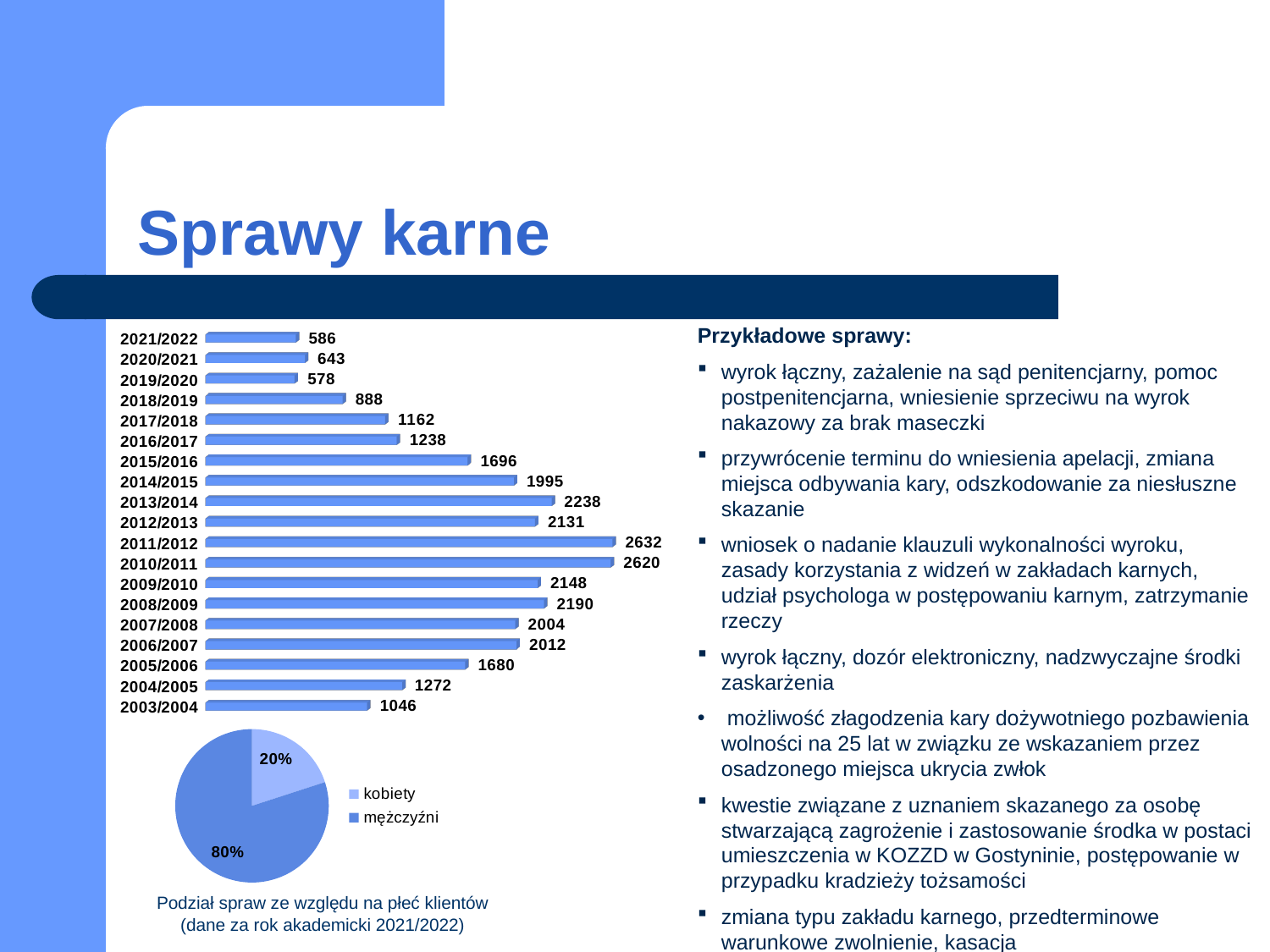
In the pie chart at the bottom left, what share is labelled for kobiety? 20% How many entries does the legend of the pie chart at the bottom left list? 2 In the bar chart on the left, which is larger: the value for 2013/2014 or the value for 2012/2013? 2013/2014 In the bar chart on the left, which academic year has the lowest value? 2019/2020 In the bar chart on the left, which academic year has the highest value? 2011/2012 In the pie chart at the bottom left, what share is labelled for mężczyźni? 80% In the bar chart on the left, what is the value for 2011/2012? 2632 In the bar chart on the left, what is the difference between the values for 2003/2004 and 2004/2005? 226 In the bar chart on the left, what is the difference between the values for 2011/2012 and 2010/2011? 12 In the bar chart on the left, what is the value for 2021/2022? 586 What kind of chart is the upper chart on the left of the slide? Bar chart In the bar chart on the left, how many academic years are shown? 19